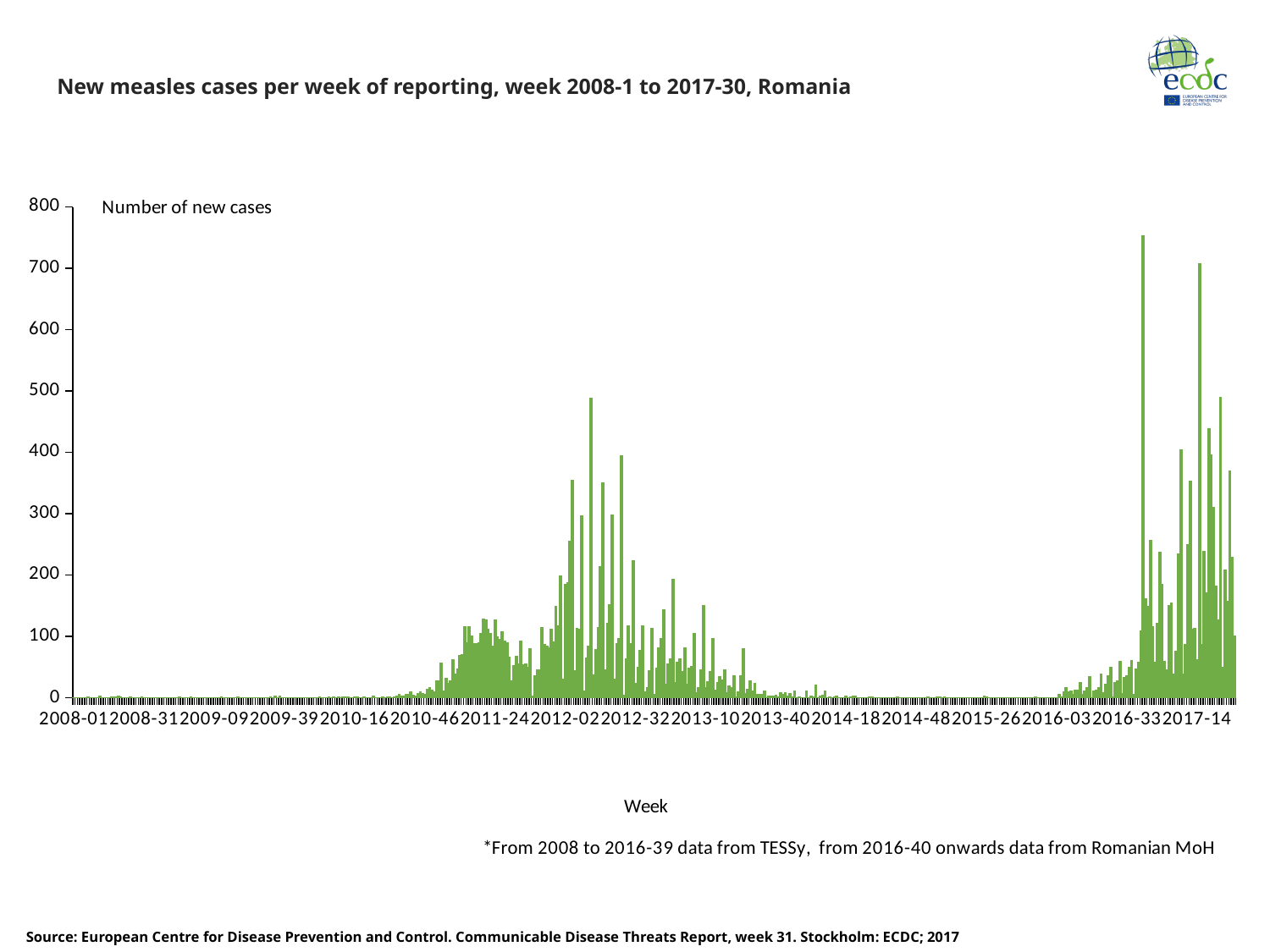
Is the number of new cases at week 2014-18 greater or less than 100? less Between week 2015-26 and week 2017-14, do the weekly case numbers generally rise or fall? rise Is the number of new cases at week 2015-26 greater or less than 100? less Is the number of new cases at week 2008-01 greater or less than 100? less Which outbreak reached a higher weekly peak: the one around 2012 or the one from late 2016 into 2017? the one from late 2016 into 2017 What kind of chart is shown on the slide? bar chart What is the title of the chart? New measles cases per week of reporting, week 2008-1 to 2017-30, Romania What label is shown on the vertical axis of the chart? Number of new cases